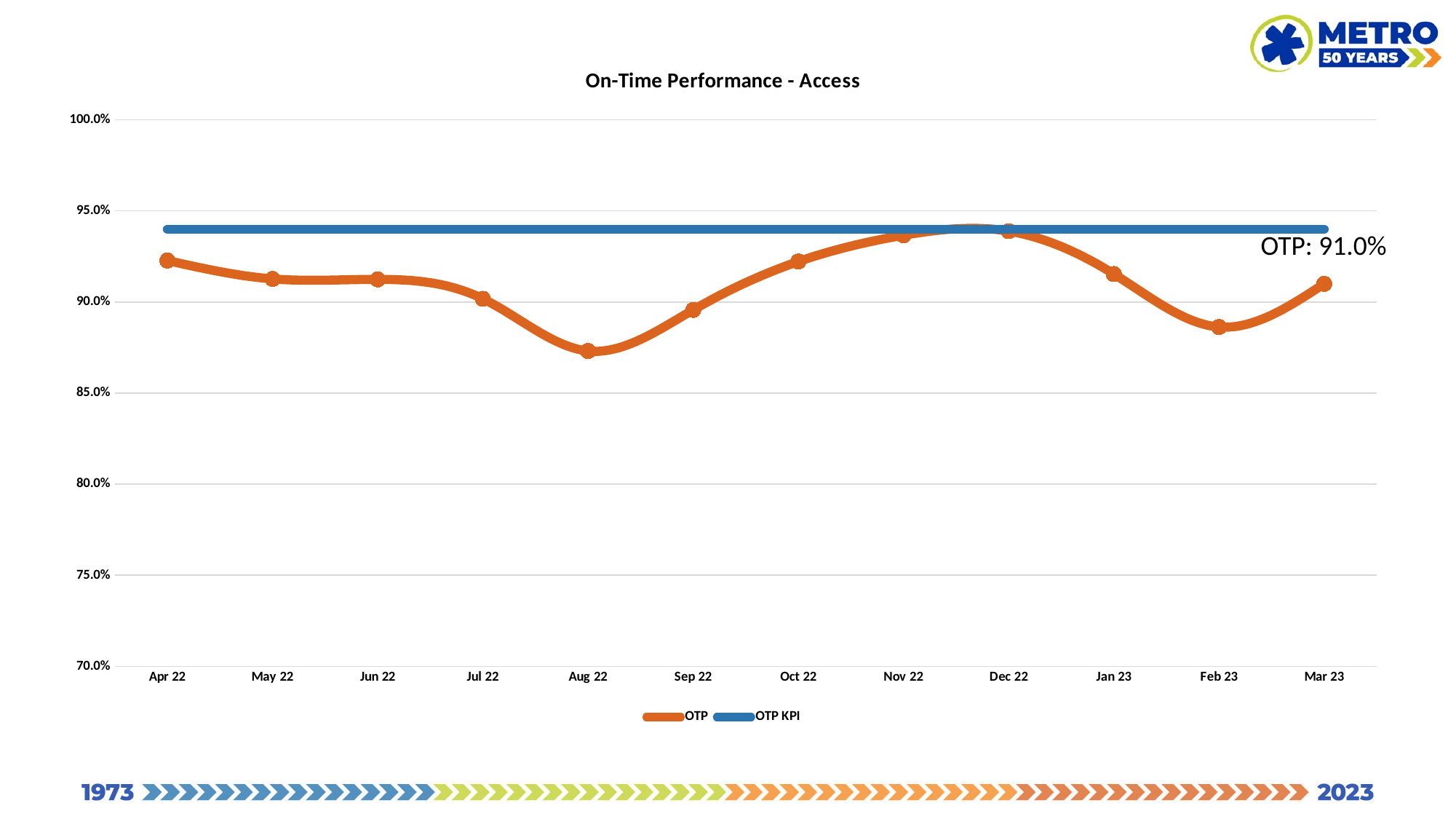
What is the OTP value for Mar 23? 91.0% Which has the higher OTP value, Apr 22 or Aug 22? Apr 22 Is the OTP KPI line greater or less than 90.0%? greater How many months are plotted on the x axis? 12 Is the OTP value for Apr 22 greater or less than 90.0%? greater How many series does the legend list? 2 Does the OTP value rise or fall from Aug 22 to Nov 22? rise Which month has the lowest OTP value? Aug 22 What is the title of the chart? On-Time Performance - Access Is the OTP value for Aug 22 greater or less than 90.0%? less What kind of chart is shown? line chart